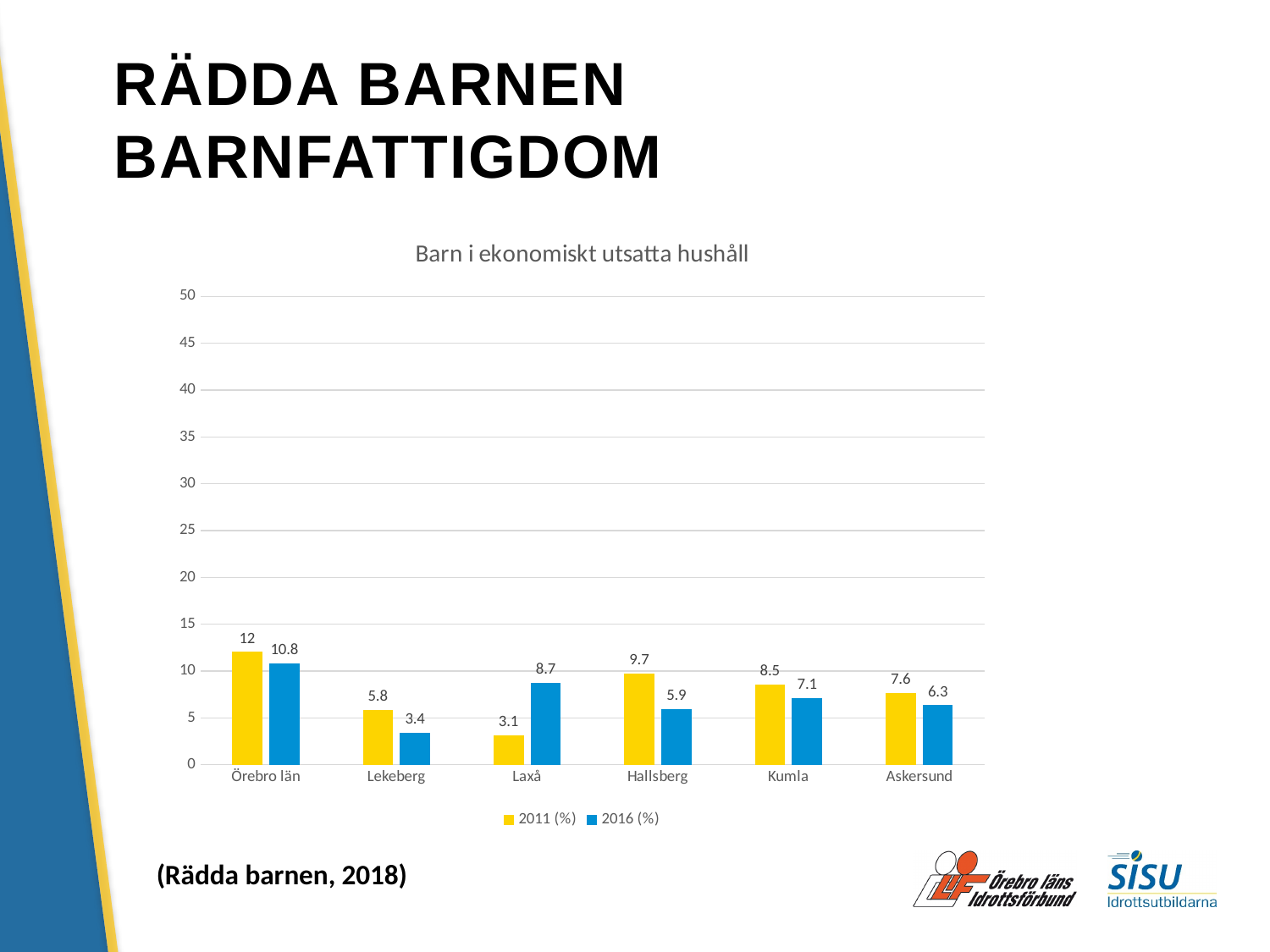
Which category has the lowest 2011 (%) value? Laxå How many series does the legend list? 2 What is the title of the chart? Barn i ekonomiskt utsatta hushåll What is the 2016 (%) value for Lekeberg? 3.4 What is the difference between the 2011 (%) and 2016 (%) values for Hallsberg? 3.8 Which is larger for Laxå: the 2011 (%) value or the 2016 (%) value? 2016 (%) What is the 2016 (%) value for Laxå? 8.7 Which category has the highest 2011 (%) value? Örebro län What is the 2011 (%) value for Örebro län? 12 Is the 2011 (%) value for Kumla greater or less than 10? less How many categories are shown on the x axis? 6 Which category has the lowest 2016 (%) value? Lekeberg